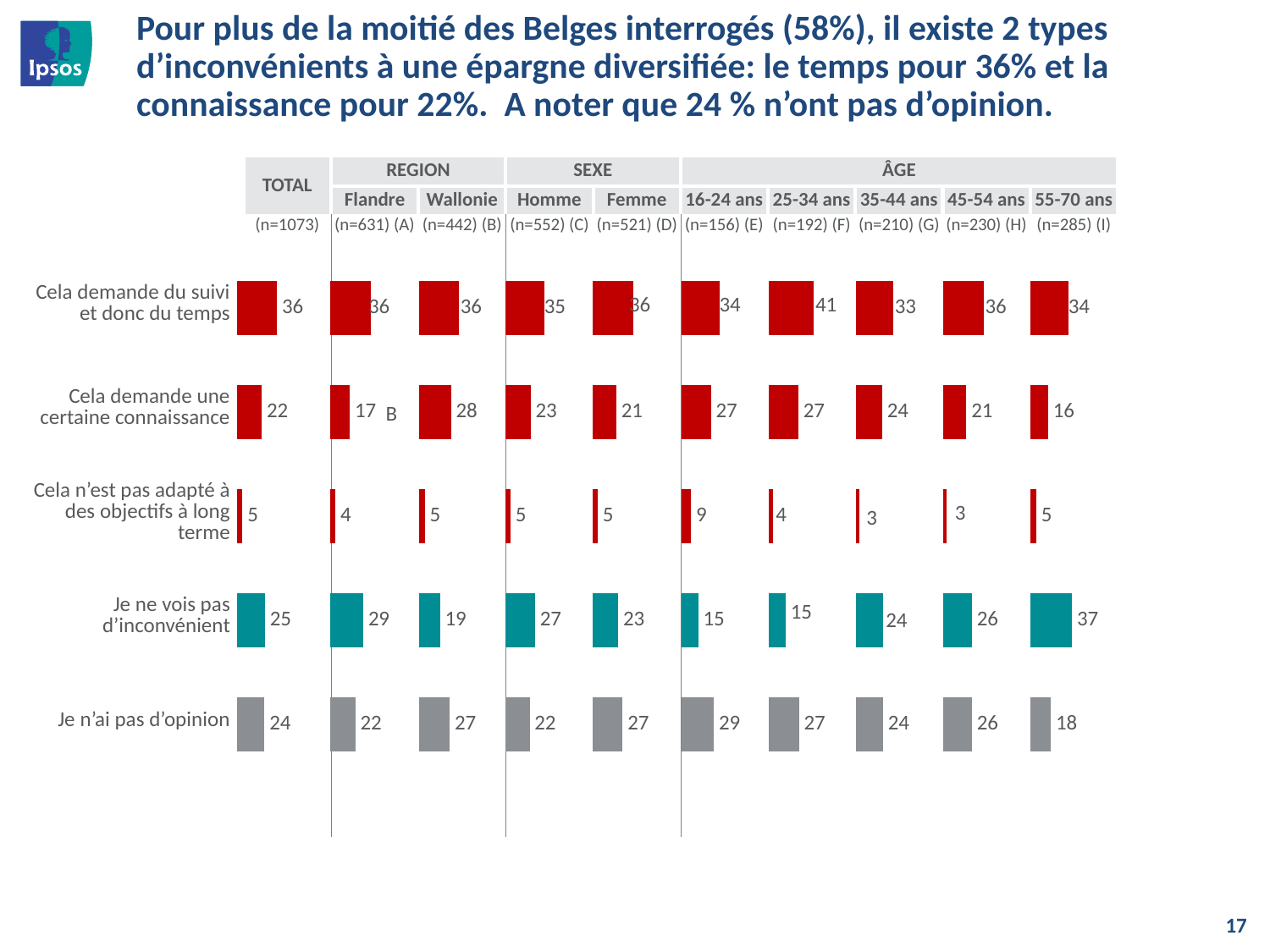
In the 55-70 ans column, what is the value for "Je ne vois pas d'inconvénient"? 37 What is the sample size (n) for the TOTAL column? n=1073 What kind of chart is used on this slide? Bar chart What is the difference between Wallonie and Flandre for "Cela demande une certaine connaissance"? 11 How many response categories (rows) are shown in the chart? 5 How many age groups are shown under ÂGE? 5 In the 16-24 ans column, what is the value for "Je n'ai pas d'opinion"? 29 For "Je ne vois pas d'inconvénient", which is larger: Homme or Femme? Homme In the TOTAL column, what is the value for "Cela demande du suivi et donc du temps"? 36 Across the age columns, which age group has the lowest value for "Cela demande une certaine connaissance"? 55-70 ans In the Wallonie column, what is the value for "Cela demande une certaine connaissance"? 28 Across the age columns, which age group has the highest value for "Cela demande du suivi et donc du temps"? 25-34 ans